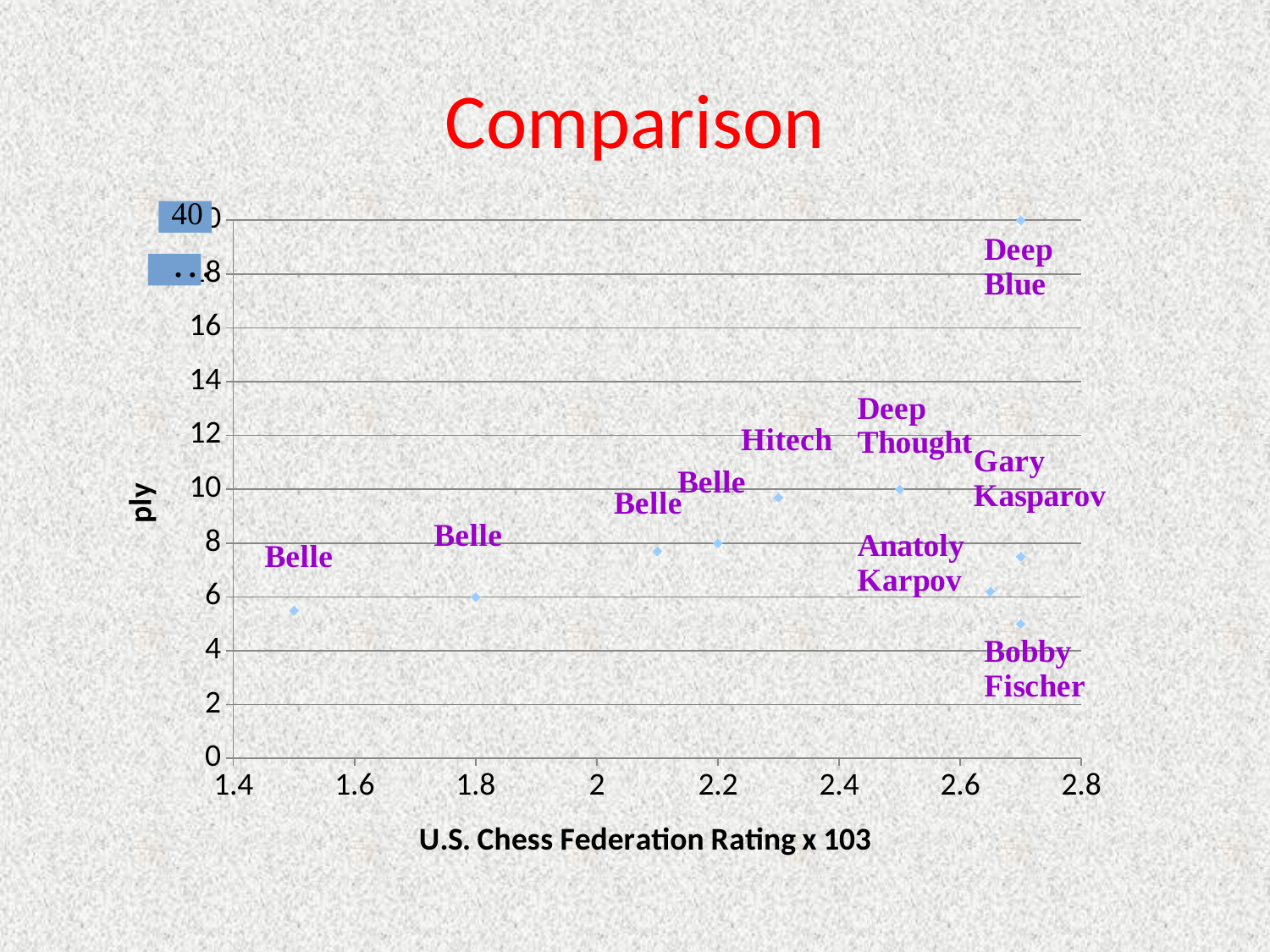
Which labelled point has the highest ply value? Deep Blue What is the ply value for the Belle point at a rating of 2.2? 8 Which labelled point has the lowest ply value? Bobby Fischer What kind of chart is shown on the slide? scatter chart Which has a higher ply value, Gary Kasparov or Anatoly Karpov? Gary Kasparov What is the title of the y axis of the chart? ply Is the ply value for Anatoly Karpov greater or less than 8? less How many data points are plotted on the chart? 10 Is the ply value for Hitech greater or less than 8? greater What is the ply value for the Belle point at a rating of 1.8? 6 What is the title of the x axis of the chart? U.S. Chess Federation Rating x 103 What is the ply value for Deep Thought? 10